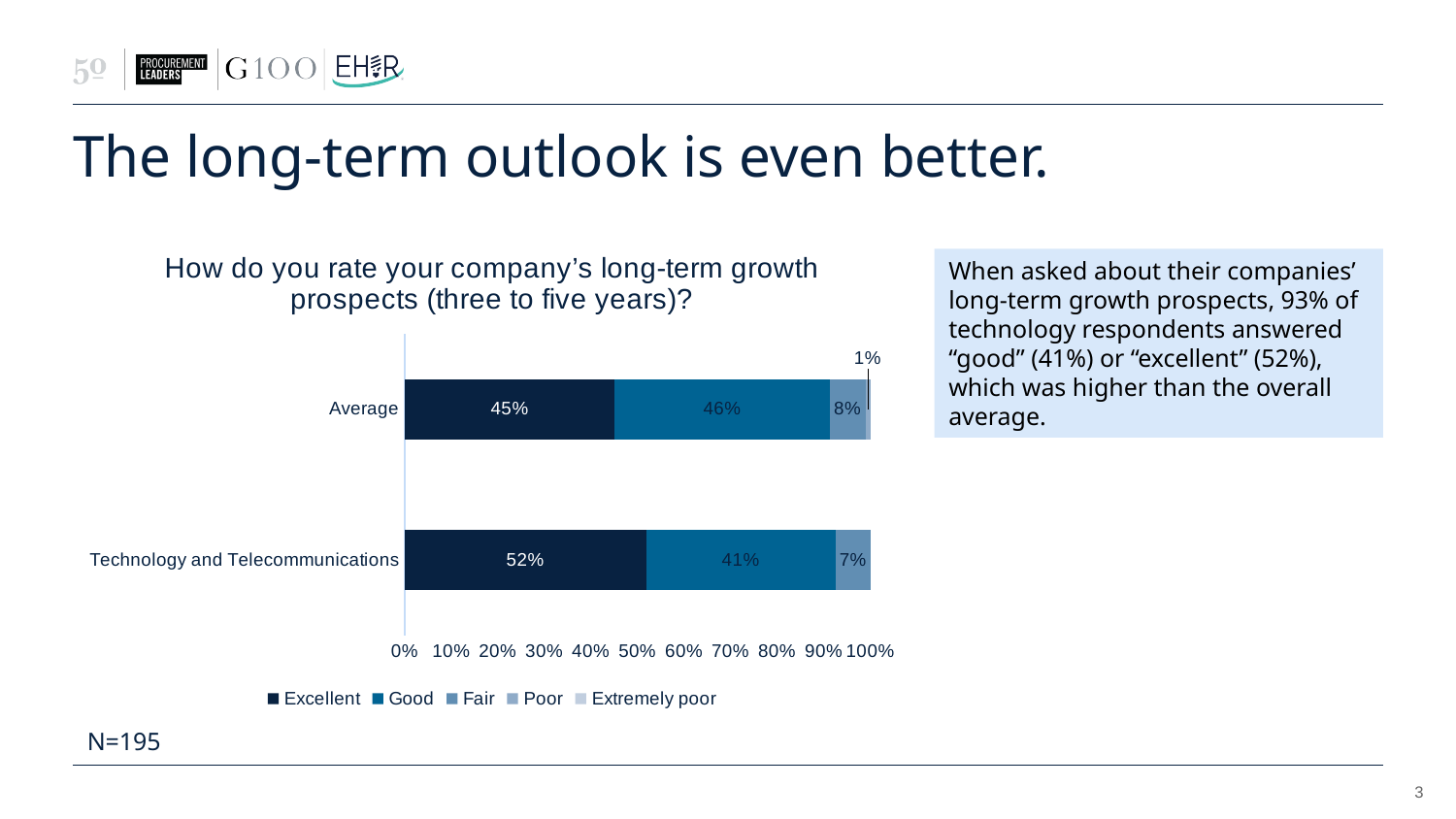
What is the difference between the "Excellent" values for Technology and Telecommunications and Average? 7% How many categories are shown on the chart? 2 How many series does the legend list? 5 What is the "Excellent" value for Average? 45% What kind of chart is shown on the slide? Stacked bar chart What is the "Fair" value for Technology and Telecommunications? 7% What is the "Good" value for Average? 46% What is the "Poor" value for Average? 1% What is the "Excellent" value for Technology and Telecommunications? 52% Which category has the higher "Excellent" value, Average or Technology and Telecommunications? Technology and Telecommunications What is the sample size (N) stated below the chart? N=195 What is the difference between the "Good" values for Average and Technology and Telecommunications? 5%